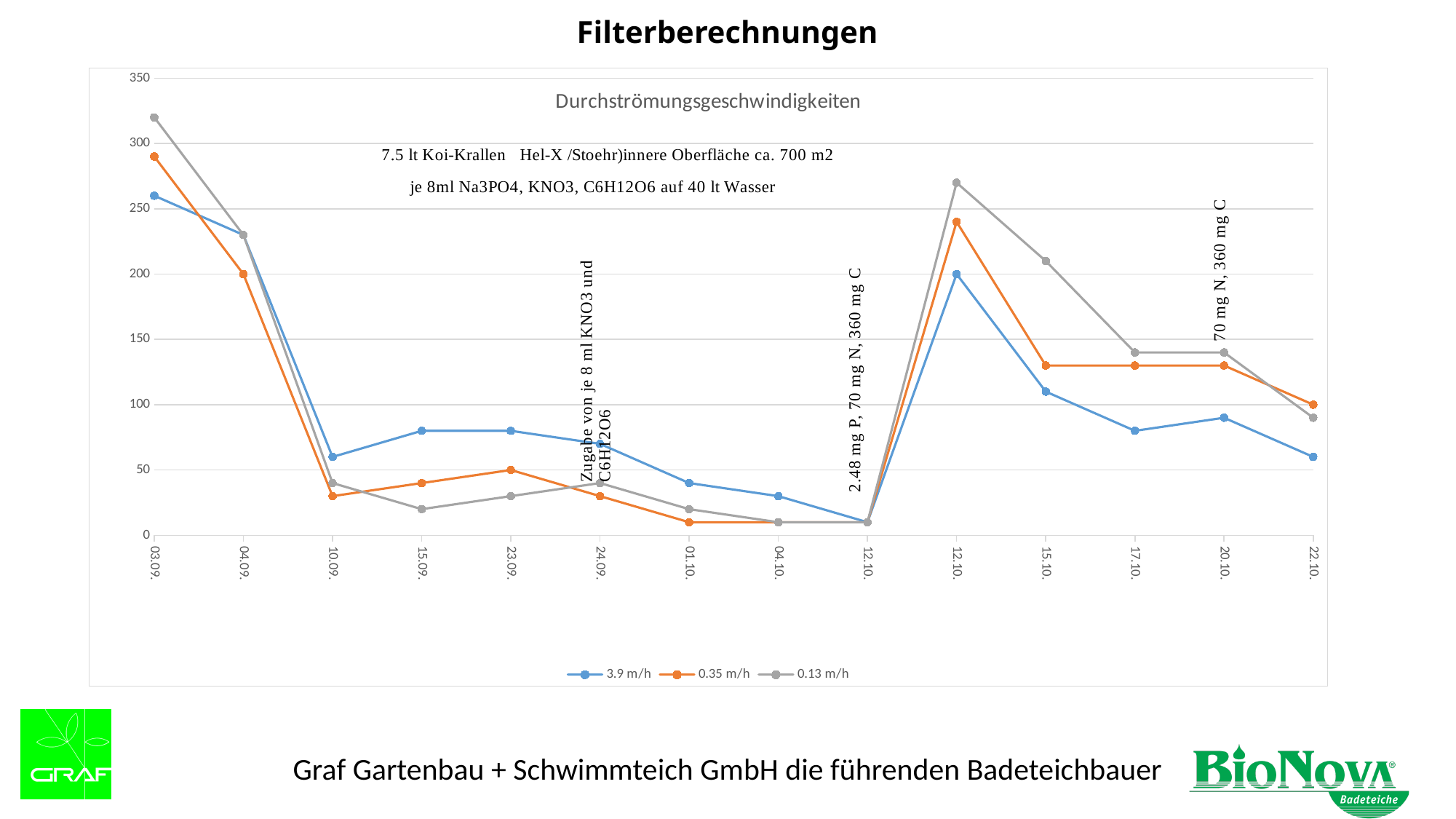
How many dates are shown along the x axis of the chart? 14 Which series has the lowest value on 17.10.? 3.9 m/h What kind of chart is shown on the slide? line chart Is the value for the 3.9 m/h series on 22.10. greater or less than 100? less How many series does the legend of the chart list? 3 Which series has the lowest value on 03.09.? 3.9 m/h Which is larger on 15.10., the value for 0.13 m/h or the value for 3.9 m/h? 0.13 m/h Which series has the highest value on 03.09.? 0.13 m/h Which series is drawn in orange in the chart? 0.35 m/h Do the values of all three series rise or fall between 03.09. and 10.09.? fall What is the title shown inside the chart area? Durchströmungsgeschwindigkeiten Is the value for the 0.13 m/h series on 03.09. greater or less than 300? greater